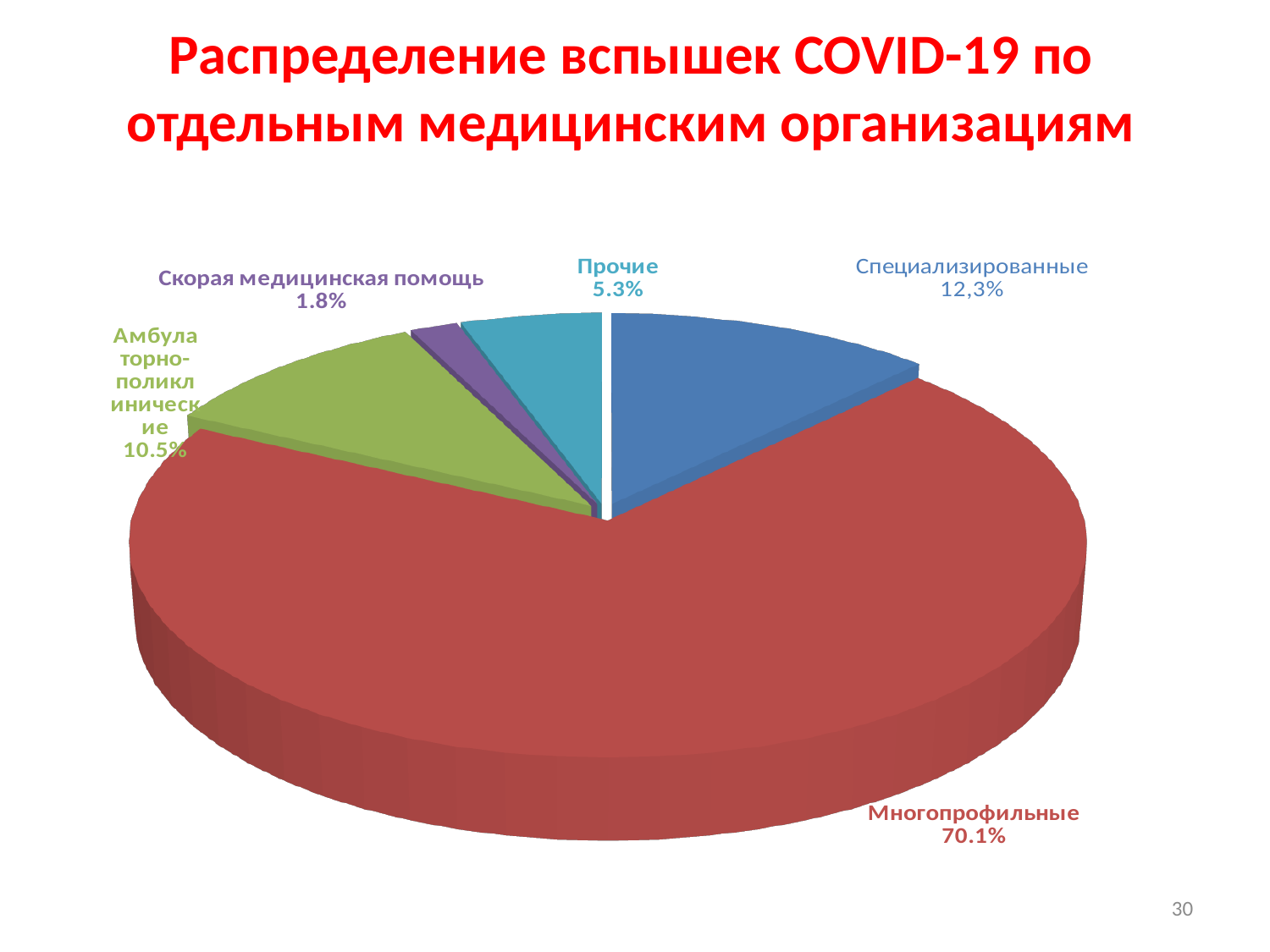
Which category has the smallest share of the pie? Скорая медицинская помощь What share is shown for Специализированные organisations? 12,3% What is the difference between the shares for Многопрофильные and Амбулаторно-поликлинические? 59.6% Which is larger, the share for Специализированные or the share for Прочие? Специализированные What is the title of the chart on the slide? Распределение вспышек COVID-19 по отдельным медицинским организациям What share is shown for Скорая медицинская помощь? 1.8% What share is shown for Амбулаторно-поликлинические organisations? 10.5% How many slices does the pie chart have? 5 What share of COVID-19 outbreaks is attributed to Многопрофильные organisations? 70.1% Which category has the largest share of the pie? Многопрофильные What share is shown for Прочие? 5.3% What kind of chart is shown on the slide? pie chart